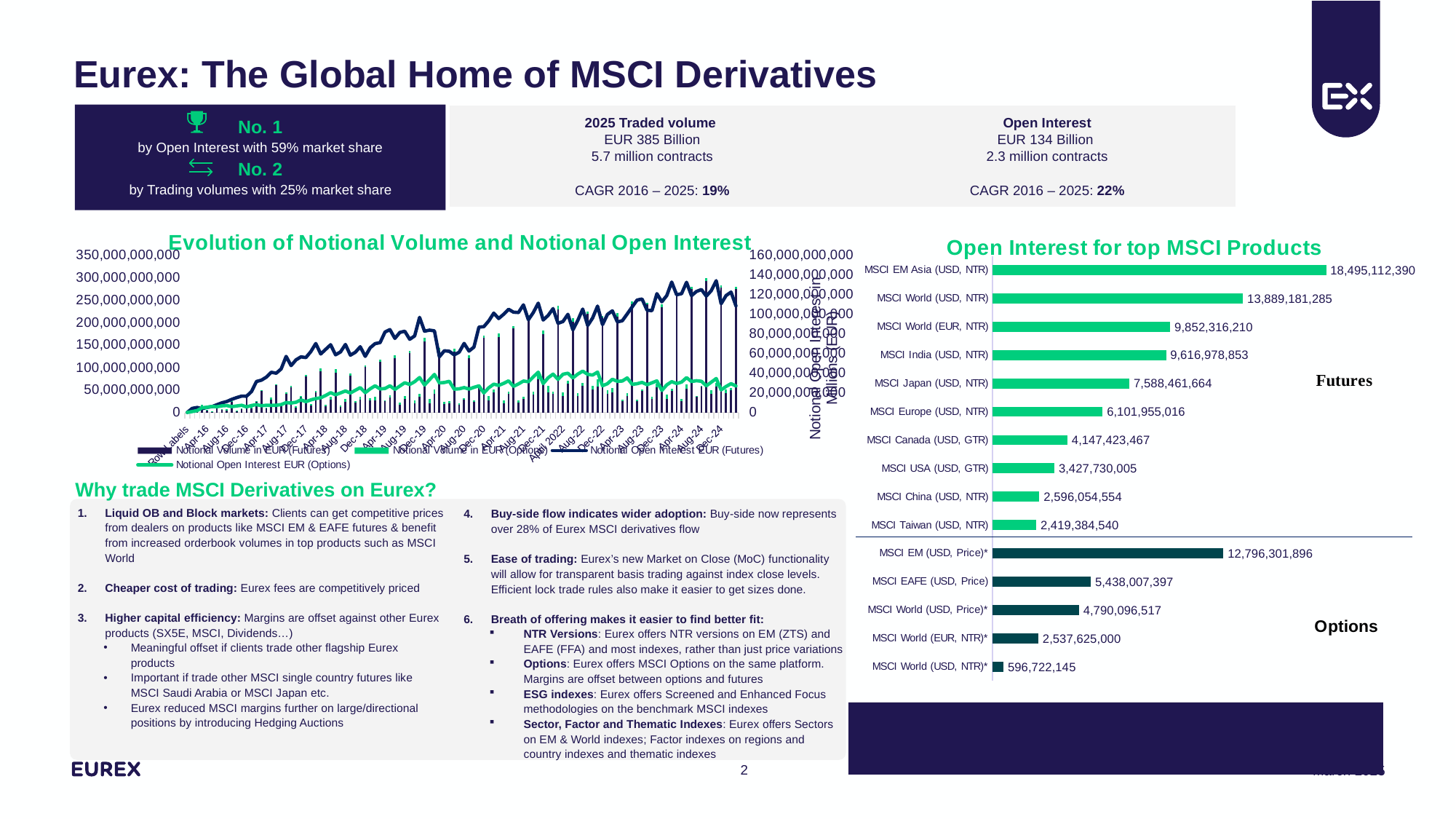
In the 'Evolution of Notional Volume and Notional Open Interest' chart, does the Notional Open Interest EUR (Futures) line generally rise or fall from 2016 to 2024? Rise How many series does the legend of the 'Evolution of Notional Volume and Notional Open Interest' chart list? 4 In the 'Open Interest for top MSCI Products' chart, what is the difference in open interest between MSCI EM Asia (USD, NTR) and MSCI World (USD, NTR)? 4,605,931,105 In the 'Open Interest for top MSCI Products' chart, which product has the highest open interest? MSCI EM Asia (USD, NTR) In the 'Open Interest for top MSCI Products' chart, which has the larger open interest: MSCI India (USD, NTR) or MSCI Europe (USD, NTR)? MSCI India (USD, NTR) In the 'Open Interest for top MSCI Products' chart, which product has the lowest open interest? MSCI World (USD, NTR)* What kind of chart is 'Open Interest for top MSCI Products'? Bar chart In the 'Open Interest for top MSCI Products' chart, what is the open interest for MSCI Japan (USD, NTR)? 7,588,461,664 How many products are shown in the 'Open Interest for top MSCI Products' chart? 15 In the 'Open Interest for top MSCI Products' chart, what is the open interest for MSCI EM Asia (USD, NTR)? 18,495,112,390 In the 'Open Interest for top MSCI Products' chart, what is the difference in open interest between MSCI EM (USD, Price)* and MSCI EAFE (USD, Price)? 7,358,294,499 In the 'Open Interest for top MSCI Products' chart, what is the open interest for MSCI EAFE (USD, Price)? 5,438,007,397